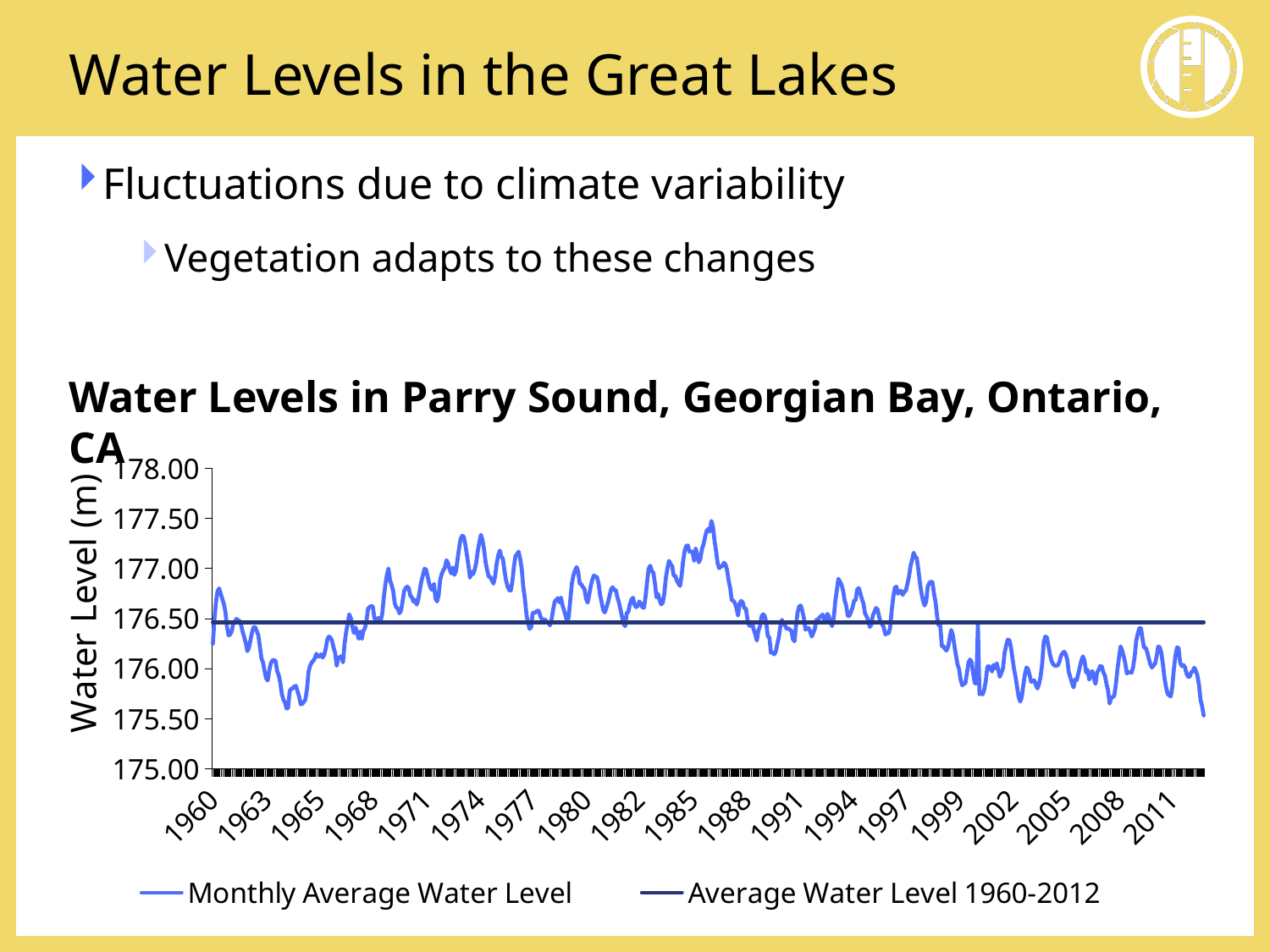
What is the label of the vertical axis of the chart? Water Level (m) Is the Monthly Average Water Level around 1974 greater or less than 176.50? greater Are the Monthly Average Water Level values after 1999 generally higher or lower than the Average Water Level 1960-2012 line? lower Is the Average Water Level 1960-2012 line greater or less than 176.00? greater Is the Monthly Average Water Level at the end of the series (around 2012) greater or less than 176.00? less What is the title of the chart? Water Levels in Parry Sound, Georgian Bay, Ontario, CA What is the first year label shown on the x axis? 1960 How many series does the chart legend list? 2 What kind of chart is shown on the slide? line chart